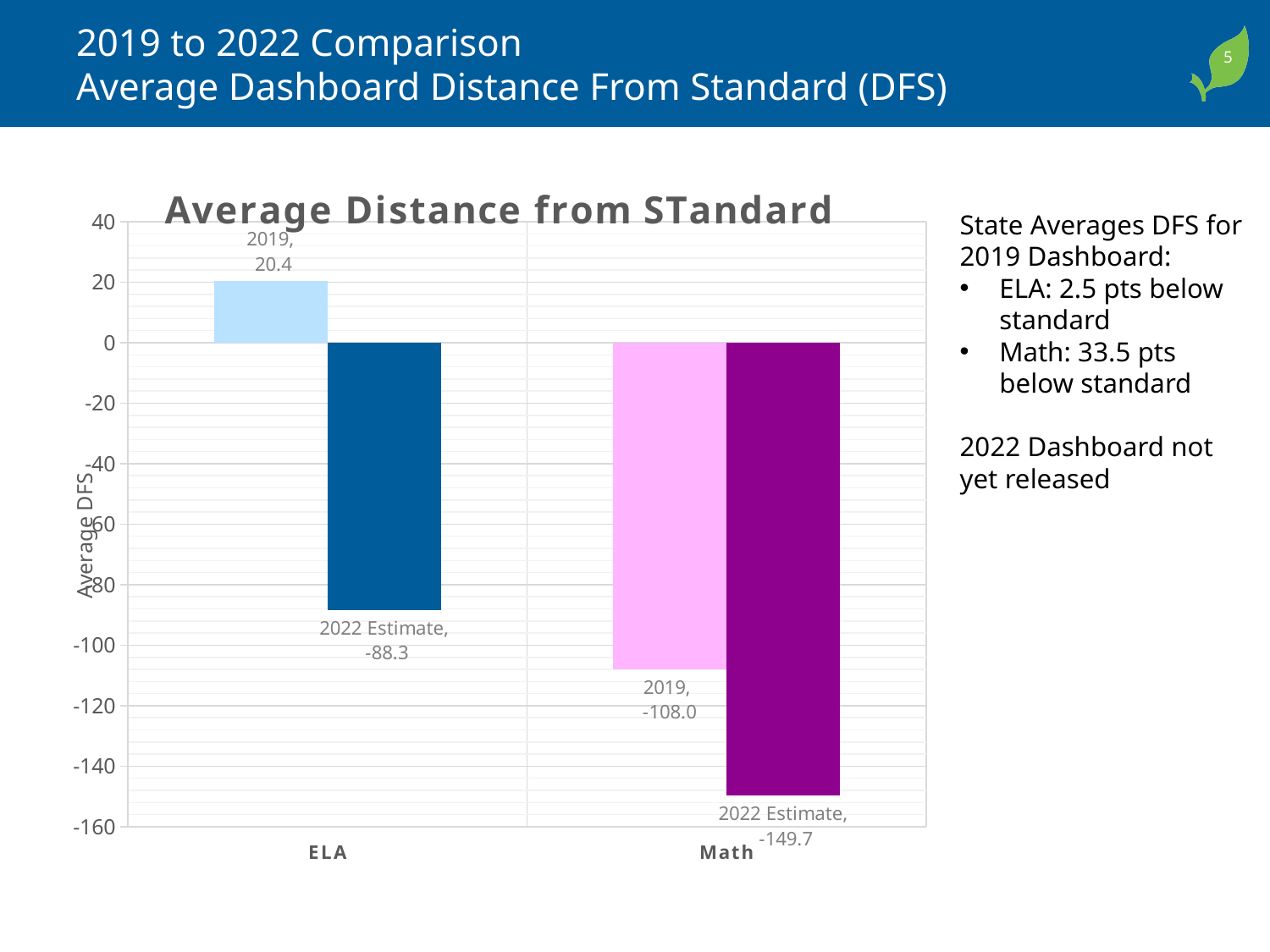
What is the 2019 value for ELA in the Average Distance from STandard chart? 20.4 Which is larger, the 2022 Estimate value for ELA or the 2019 value for Math? 2022 Estimate value for ELA Is the 2022 Estimate value for Math greater or less than -140? less What is the 2019 value for Math? -108.0 What is the 2022 Estimate value for ELA? -88.3 Which bar has the lowest value in the chart? Math, 2022 Estimate What is the label of the vertical axis of the chart? Average DFS What is the difference between the 2019 and 2022 Estimate values for Math? 41.7 How many categories are shown on the x axis of the chart? 2 What is the 2022 Estimate value for Math? -149.7 Which bar has the highest value in the chart? ELA, 2019 What kind of chart is shown on the slide? Bar chart